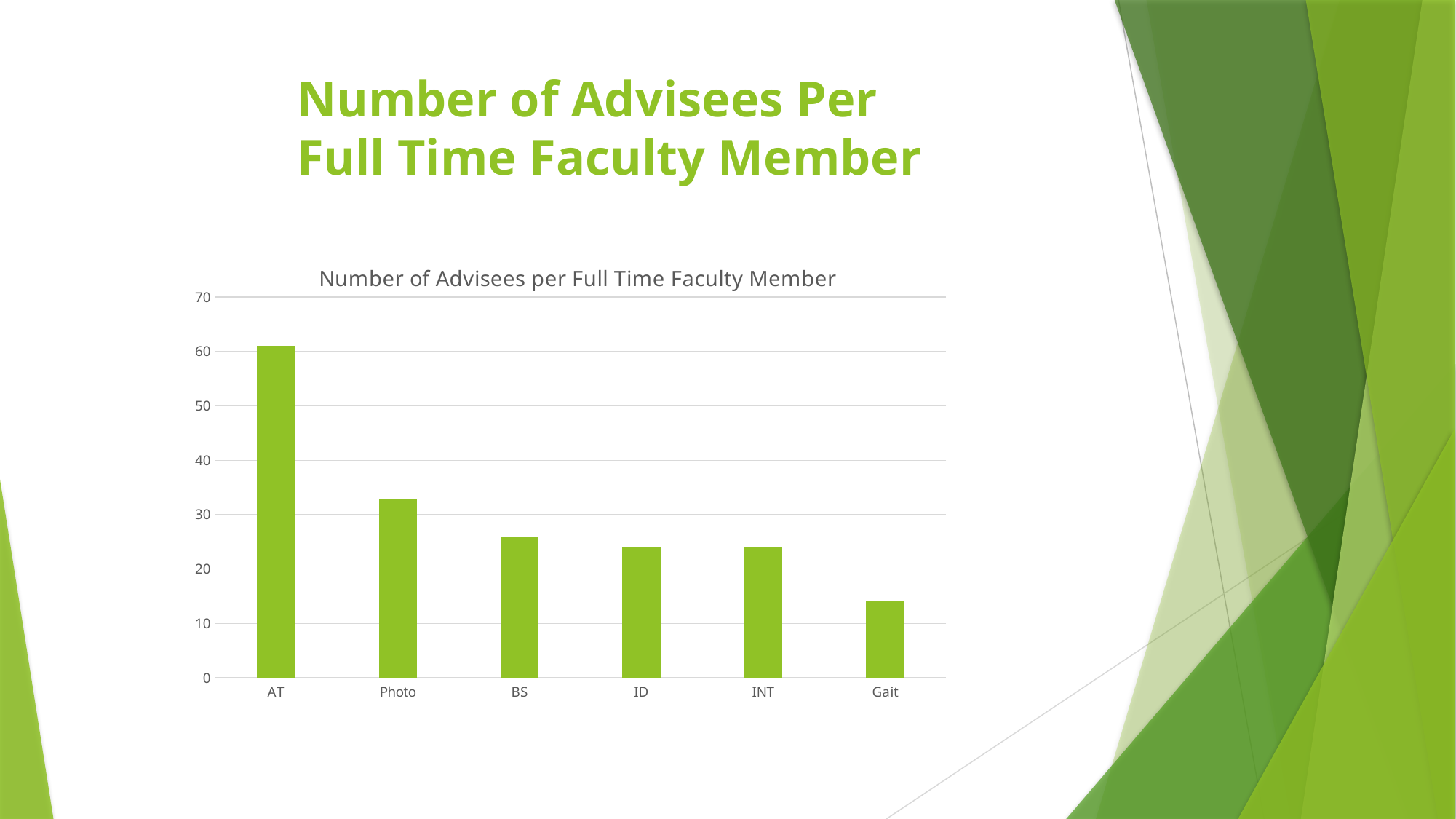
Is the value for Photo greater or less than 30? greater Which is larger, the value for ID or the value for Gait? ID Which is larger, the value for Photo or the value for BS? Photo Is the value for BS greater or less than 30? less What is the title of the chart? Number of Advisees per Full Time Faculty Member Which category has the highest number of advisees per full time faculty member? AT What kind of chart is shown on the slide? bar chart Is the value for Gait greater or less than 20? less Which category has the lowest number of advisees per full time faculty member? Gait How many categories are shown on the x axis of the chart? 6 Do the values generally rise or fall moving from AT to Gait along the x axis? fall